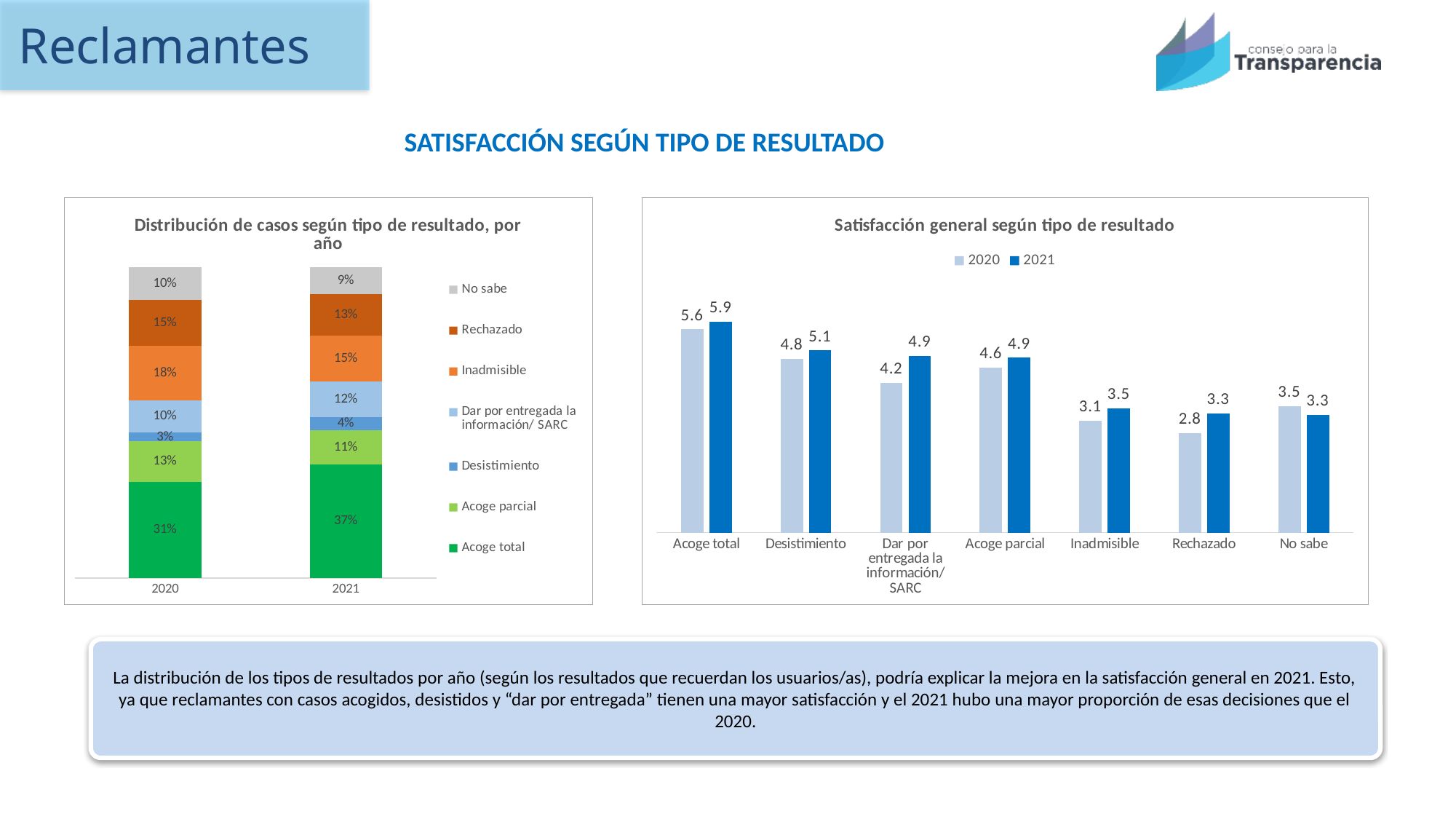
In the chart 'Distribución de casos según tipo de resultado, por año', which result type has the largest share in 2020? Acoge total In the chart 'Satisfacción general según tipo de resultado', for 'No sabe', which year has the higher value, 2020 or 2021? 2020 In the chart 'Distribución de casos según tipo de resultado, por año', which result type has the smallest share in 2021? Desistimiento In the chart 'Satisfacción general según tipo de resultado', which result type has the highest 2021 satisfaction? Acoge total In the chart 'Satisfacción general según tipo de resultado', what is the difference between the 2021 and 2020 values for 'Dar por entregada la información/ SARC'? 0.7 In the chart 'Distribución de casos según tipo de resultado, por año', what percentage of cases in 2020 were 'Inadmisible'? 18% In the chart 'Satisfacción general según tipo de resultado', what is the 2020 value for 'Dar por entregada la información/ SARC'? 4.2 In the chart 'Distribución de casos según tipo de resultado, por año', what percentage of cases in 2021 were 'Acoge total'? 37% In the chart 'Distribución de casos según tipo de resultado, por año', by how many percentage points did the 'Acoge total' share change from 2020 to 2021? 6 percentage points In the chart 'Satisfacción general según tipo de resultado', which result type has the lowest 2020 satisfaction? Rechazado In the chart 'Satisfacción general según tipo de resultado', what is the 2021 value for 'Rechazado'? 3.3 In the chart 'Distribución de casos según tipo de resultado, por año', how many result types does the legend list? 7